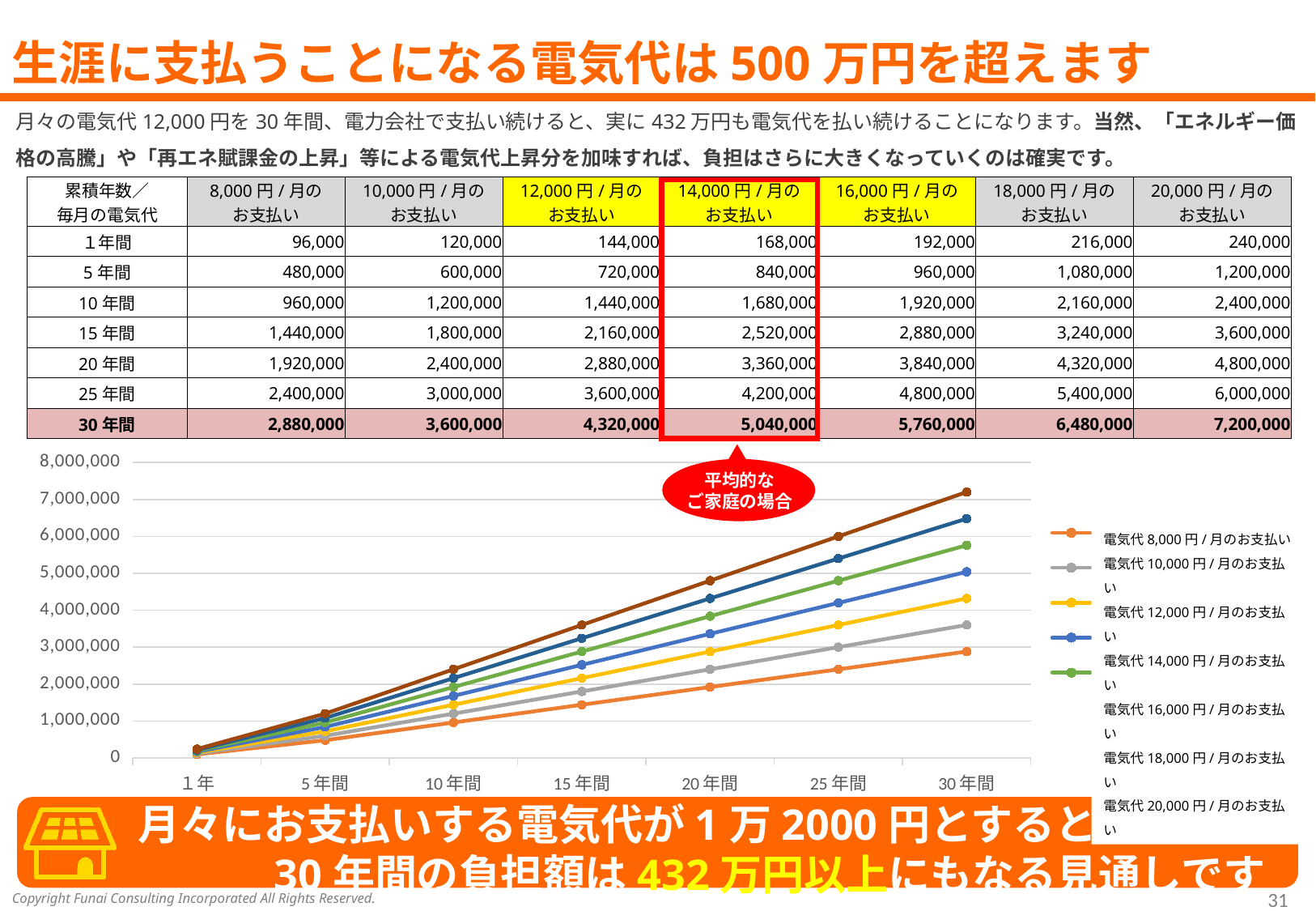
Is the value for 電気代 12,000円/月のお支払い at 30年間 greater or less than 4,000,000? greater How many series does the chart legend list? 7 At 30年間, which is larger: the 電気代 14,000円/月 series or the 電気代 10,000円/月 series? 電気代 14,000円/月 How many points are plotted along the x axis of the chart? 7 What kind of chart is shown on the slide? line chart Is the value for 電気代 8,000円/月のお支払い at 20年間 greater or less than 2,000,000? less Do the lines in the chart rise or fall from 1年 to 30年間? rise Which series is lowest at 30年間 in the chart? 電気代 8,000円/月のお支払い What is the label of the first category on the chart's x axis? 1年 Is the value for 電気代 20,000円/月のお支払い at 30年間 greater or less than 6,000,000? greater What is the highest tick value shown on the chart's y axis? 8,000,000 Which series is highest at 30年間 in the chart? 電気代 20,000円/月のお支払い